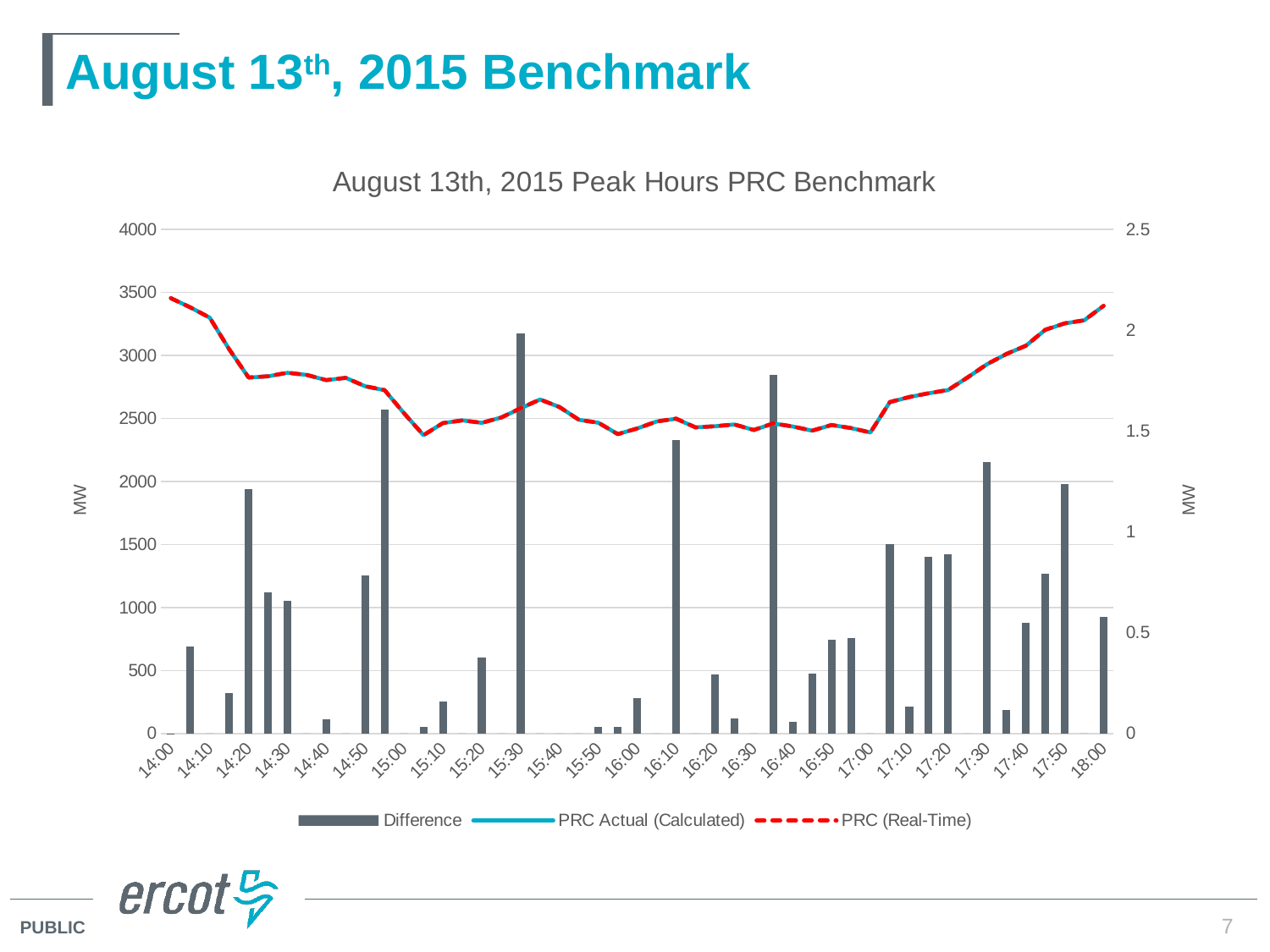
Which series is drawn as bars in the chart? Difference Which has the larger Difference value, 14:20 or 14:30? 14:20 How many series does the legend list? 3 What is the title of the chart? August 13th, 2015 Peak Hours PRC Benchmark Is the Difference value at 14:40 greater or less than 500? less Does the PRC (Real-Time) line rise or fall between 17:00 and 18:00? rise What kind of chart is shown on the slide? A combination bar and line chart At which time is the Difference bar highest? 15:30